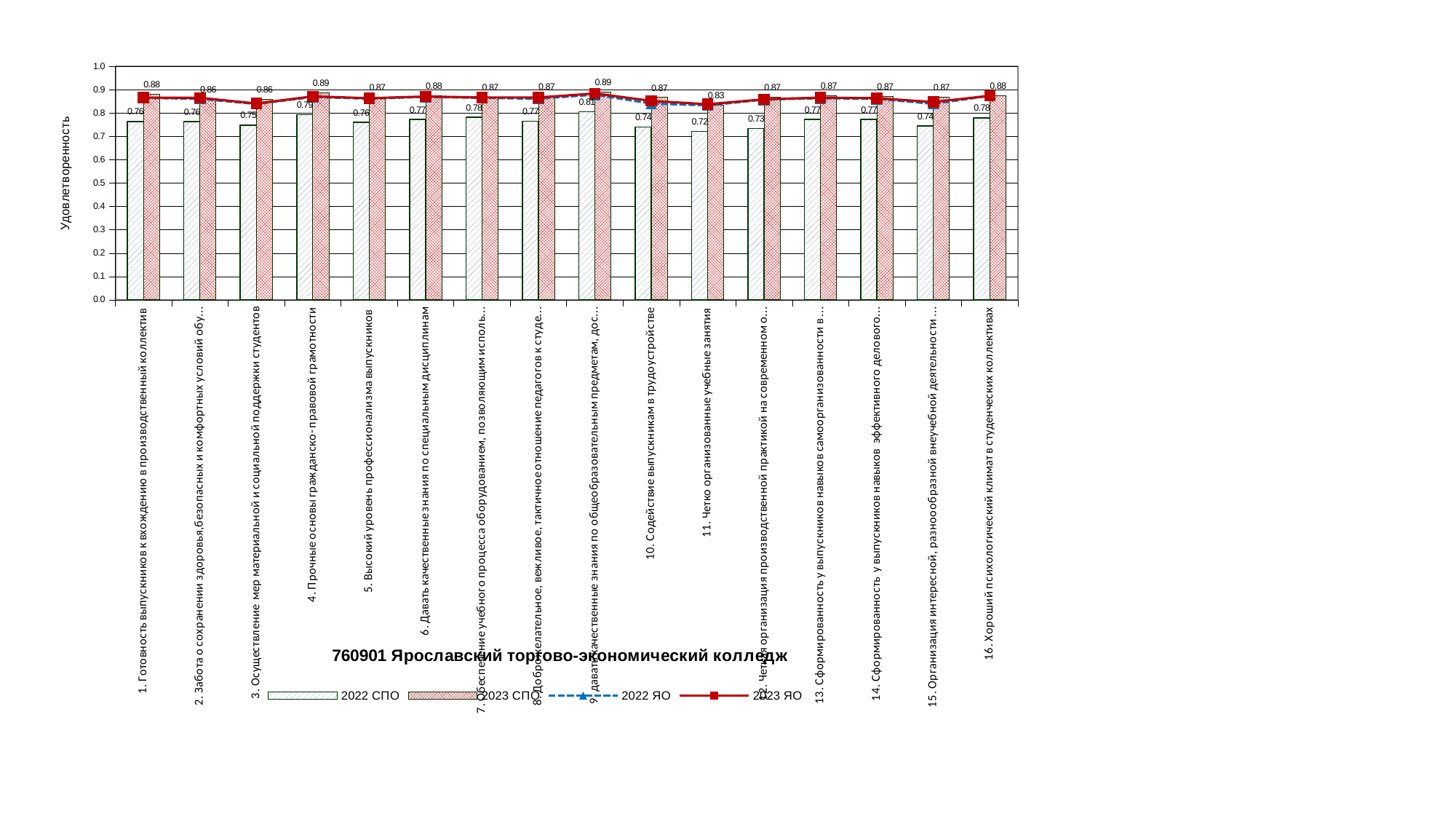
What is the title of the chart? 760901 Ярославский торгово-экономический колледж What is the 2022 СПО value for "4. Прочные основы гражданско-правовой грамотности"? 0.79 What kind of chart is shown on the slide? A combined bar and line chart How many series does the legend list? 4 What is the 2022 СПО value for "10. Содействие выпускникам в трудоустройстве"? 0.74 What is the label on the vertical axis? Удовлетворенность Is the 2023 СПО value for "16. Хороший психологический климат в студенческих коллективах" greater or less than 0.8? greater Which has the larger 2022 СПО value: "4. Прочные основы гражданско-правовой грамотности" or "5. Высокий уровень профессионализма выпускников"? 4. Прочные основы гражданско-правовой грамотности How many categories are plotted along the x axis? 16 What is the difference between the 2022 СПО values for "4. Прочные основы гражданско-правовой грамотности" and "11. Четко организованные учебные занятия"? 0.07 Which category has the lowest 2022 СПО value? 11. Четко организованные учебные занятия What is the 2022 СПО value for "11. Четко организованные учебные занятия"? 0.72